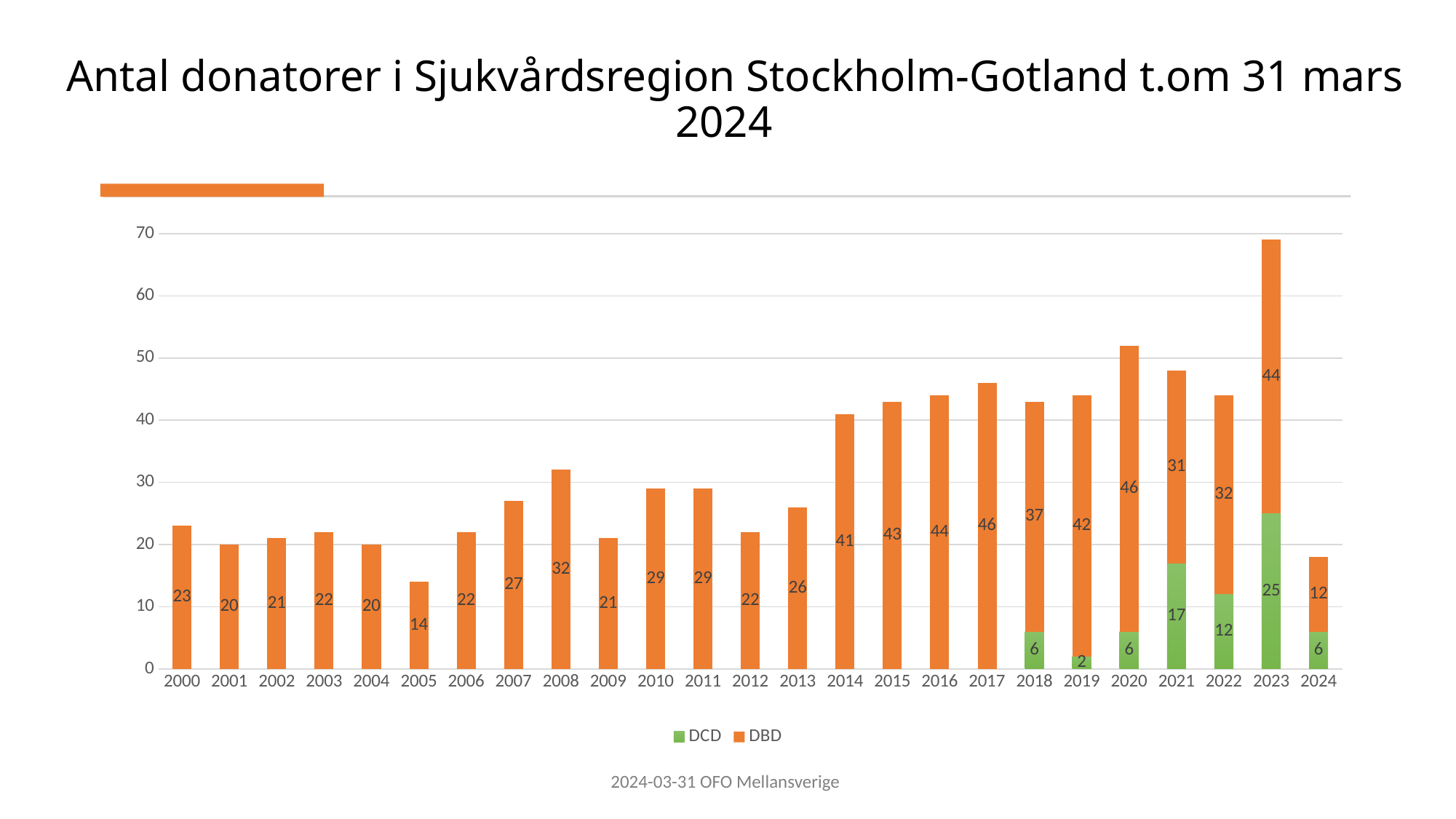
What is the DCD value for 2021? 17 What is the total number of donors (DCD plus DBD) in 2023? 69 What is the DBD value for 2017? 46 Which series is shown in green in the legend? DCD Which year has the lowest DBD value? 2024 Which is larger, the DBD value for 2014 or the DBD value for 2018? 2014 What kind of chart is shown on the slide? Stacked bar chart What is the DBD value for 2005? 14 Which year has the highest DCD value? 2023 How many series does the legend list? 2 How many years are shown on the x axis? 25 What is the difference between the DBD values for 2008 and 2009? 11